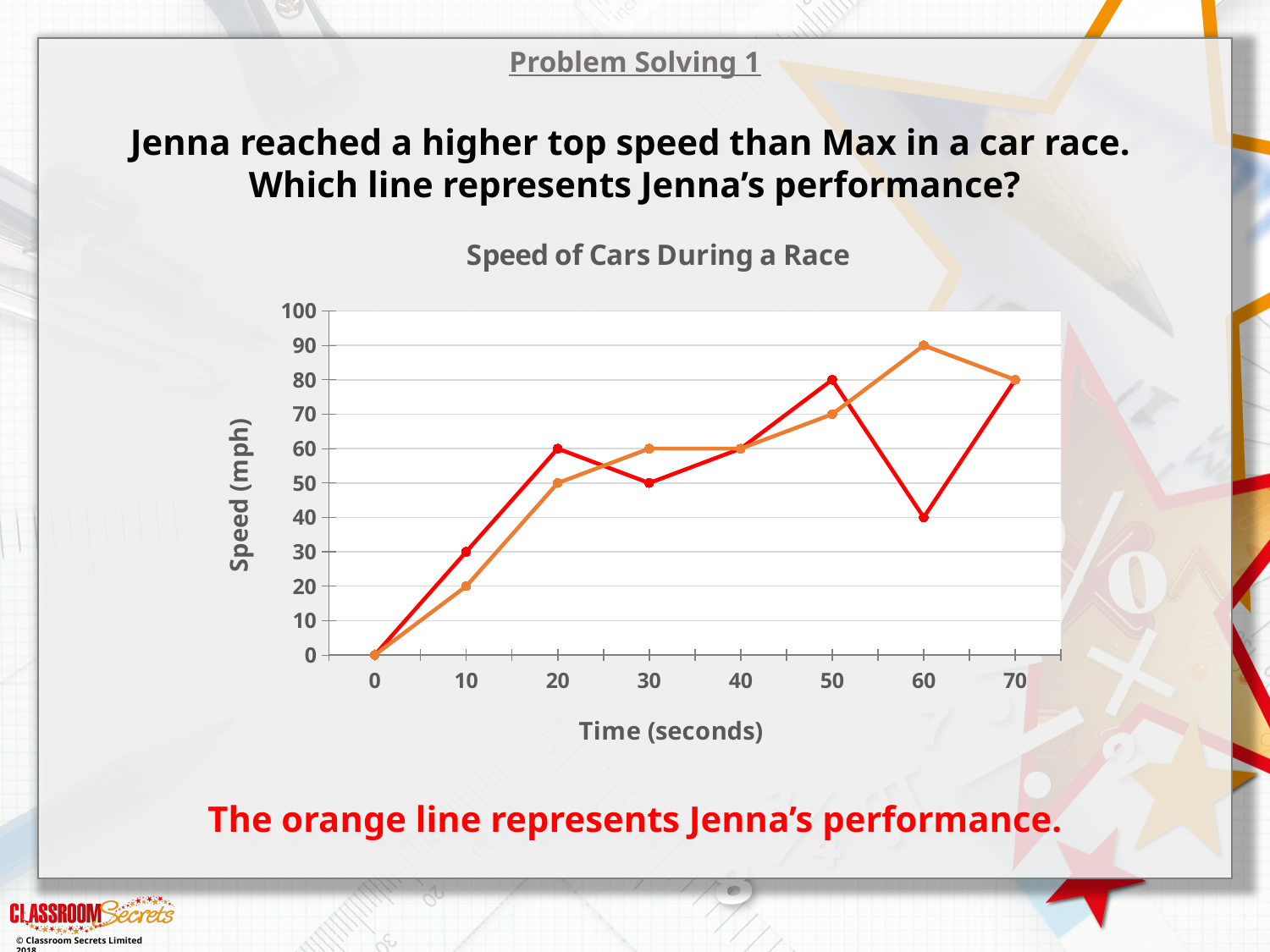
What is the speed of the orange line at 20 seconds? 50 How many lines are plotted on the chart? 2 What is the speed of the red line at 10 seconds? 30 How many time points are plotted on the x axis for each line? 8 Does the red line rise or fall between 50 and 60 seconds? fall What is the speed of the red line at 60 seconds? 40 What is the title of the chart? Speed of Cars During a Race At 50 seconds, which line shows the higher speed, red or orange? red At what time does the orange line reach its highest speed? 60 What is the difference in speed between the orange line and the red line at 60 seconds? 50 What type of chart is shown on the slide? line chart What is the speed of the orange line at 60 seconds? 90